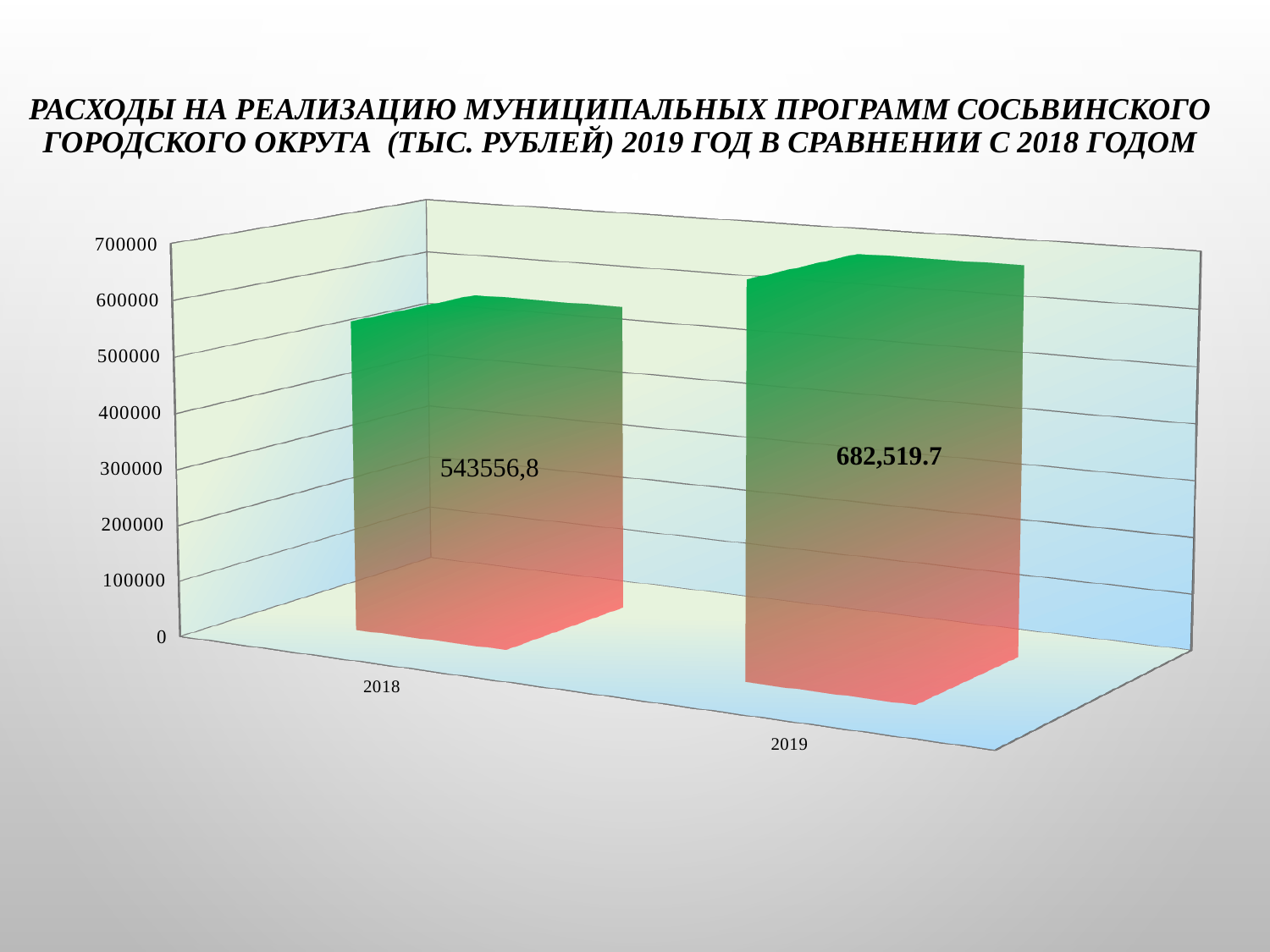
How many bars are plotted on the chart? 2 What kind of chart is shown on the slide? bar chart What is the value shown for 2018? 543556,8 What is the highest value marked on the vertical axis? 700000 Is the value for 2018 greater or less than 500000? greater Is the value for 2019 greater or less than 700000? less What is the value shown for 2019? 682,519.7 Is the value for 2019 larger or smaller than the value for 2018? larger Do the values rise or fall from 2018 to 2019? rise In what unit are the expenses given according to the chart title? тыс. рублей Which year has the lower value? 2018 Which year has the higher value? 2019